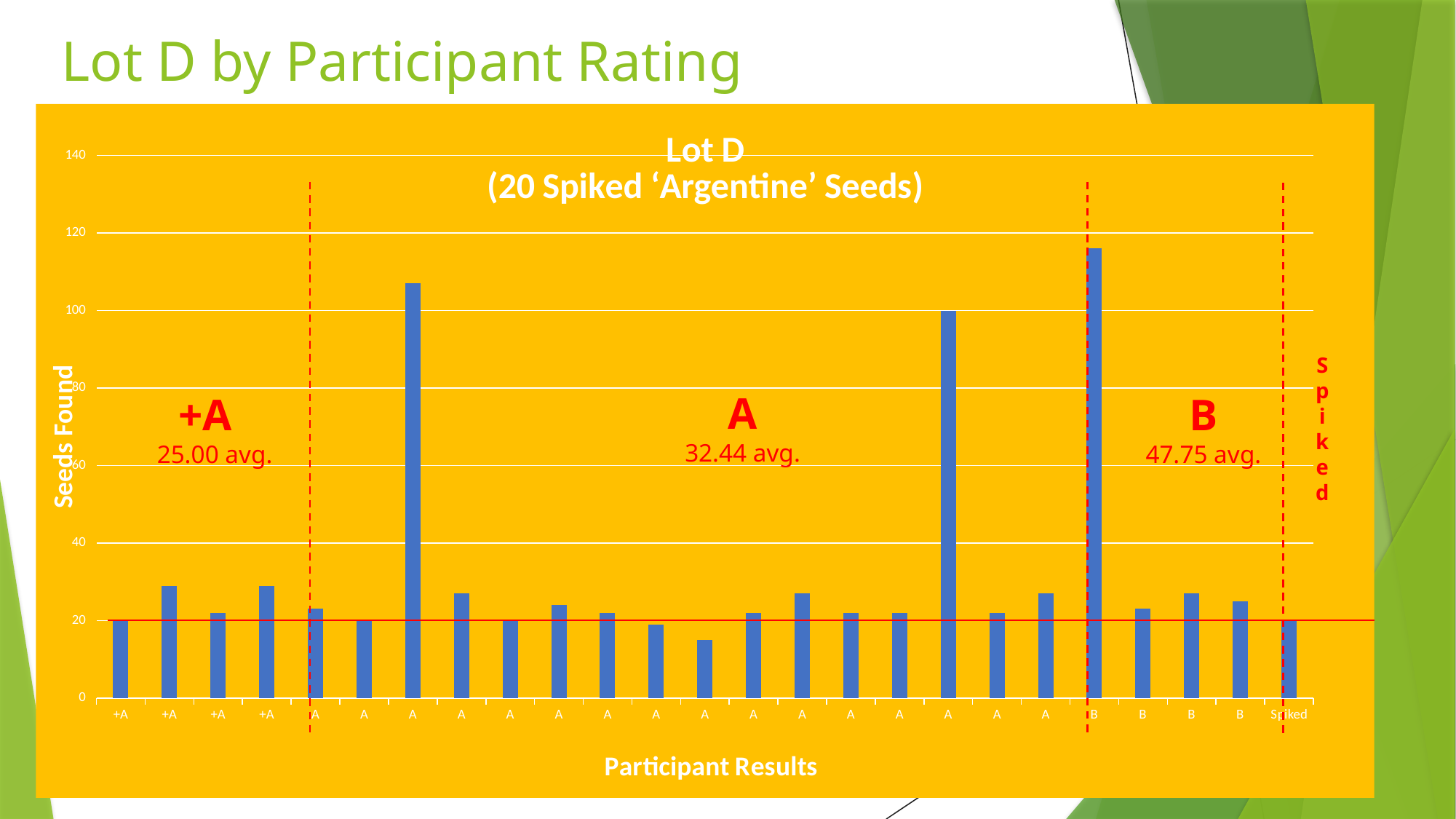
What kind of chart is shown on the slide? bar chart Is the value of the tallest bar in the +A group greater or less than 40? less What average is printed for the A group? 32.44 avg. What is the label of the vertical axis? Seeds Found What average is printed for the +A group? 25.00 avg. How many bars are plotted in the chart? 25 Which participant rating group contains the tallest bar? B What is the title of the chart? Lot D (20 Spiked 'Argentine' Seeds) How many bars are labelled B on the x axis? 4 How many bars are labelled +A on the x axis? 4 Is the value of the tallest bar in the B group greater or less than 100? greater What average is printed for the B group? 47.75 avg.